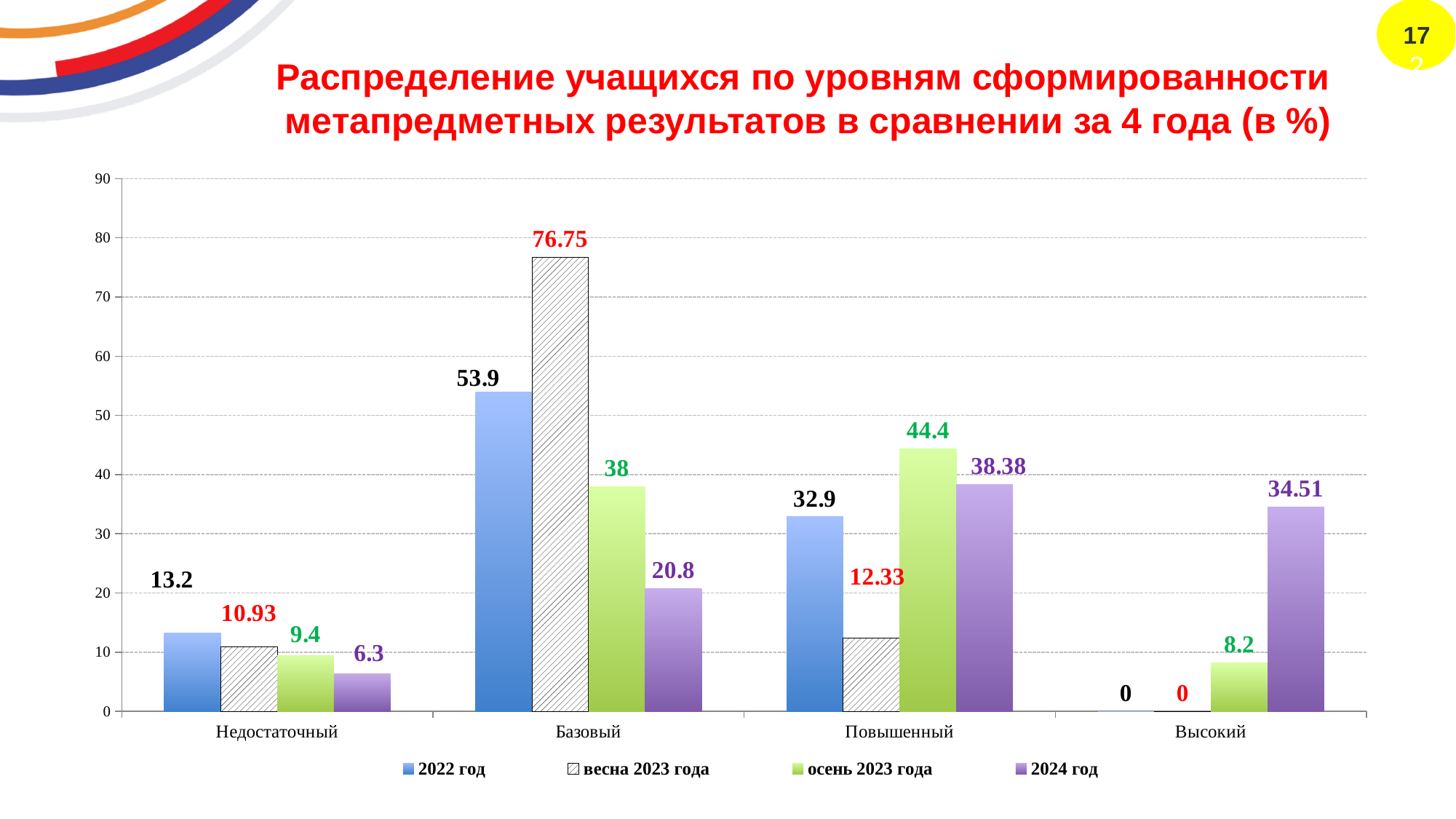
Which category has the lowest value for the "2024 год" series? Недостаточный Is the value for "весна 2023 года" in the "Базовый" category greater or less than 70? greater What is the difference between the "2022 год" and "2024 год" values in the "Базовый" category? 33.1 What is the value for "2024 год" in the "Высокий" category? 34.51 What is the value for "весна 2023 года" in the "Повышенный" category? 12.33 How many series does the legend list? 4 What is the value for "2022 год" in the "Базовый" category? 53.9 What is the value for "осень 2023 года" in the "Недостаточный" category? 9.4 Which category has the highest value for the "весна 2023 года" series? Базовый In the "Повышенный" category, which is larger: the value for "осень 2023 года" or for "2024 год"? осень 2023 года How many categories are shown on the x axis? 4 What kind of chart is shown on the slide? bar chart